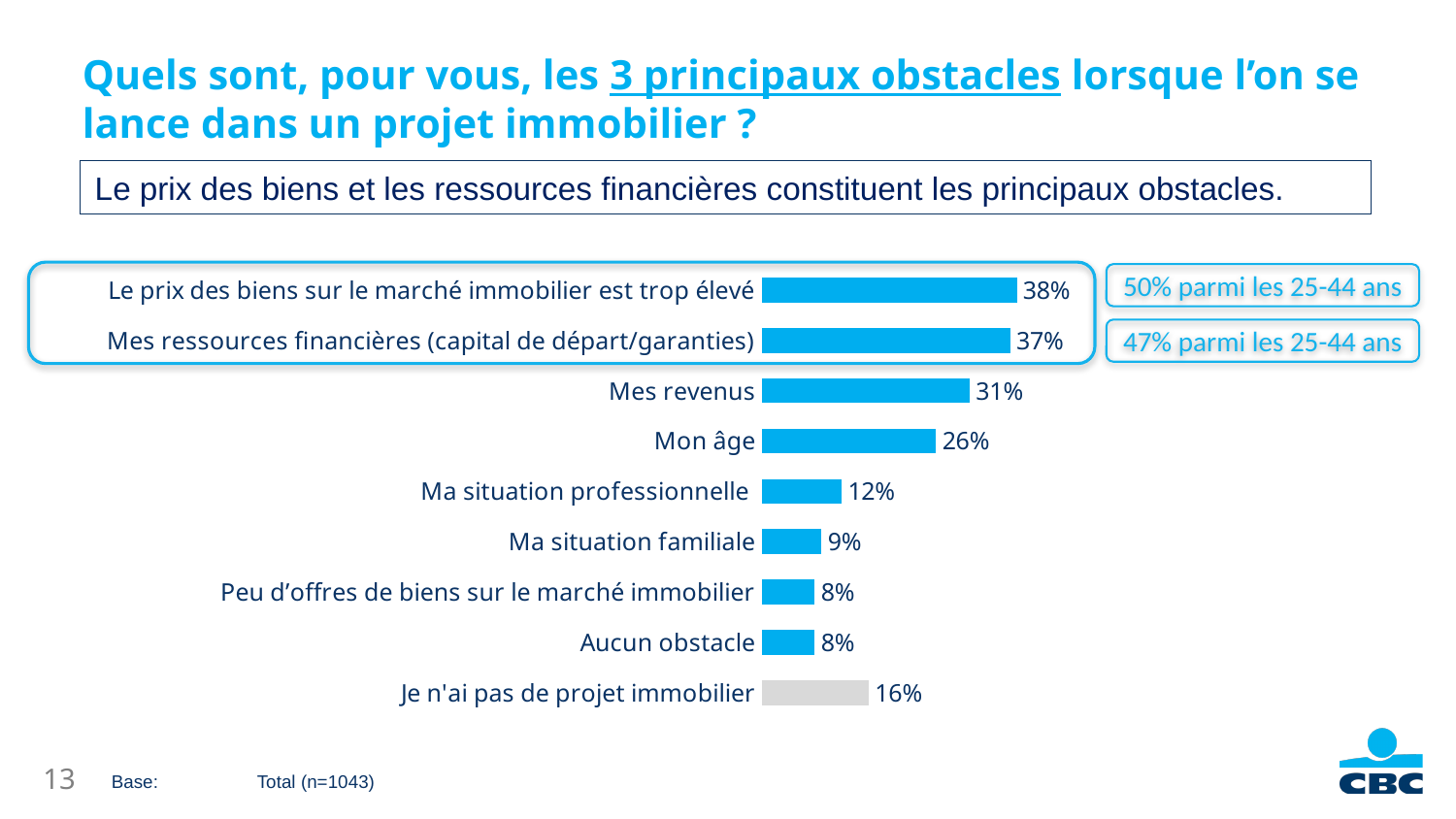
What is the value for "Ma situation professionnelle"? 12% What is the value for "Mes revenus"? 31% What is the difference between "Mes revenus" and "Mon âge"? 5% Which bar is shown in a different colour (grey) from the others? Je n'ai pas de projet immobilier What is the value for "Je n'ai pas de projet immobilier"? 16% What is the value for "Ma situation familiale"? 9% What is the value for "Mon âge"? 26% How many categories are shown in the chart? 9 What kind of chart is shown on the slide? Bar chart Which is larger, "Ma situation professionnelle" or "Ma situation familiale"? Ma situation professionnelle What is the difference between "Le prix des biens sur le marché immobilier est trop élevé" and "Mes ressources financières (capital de départ/garanties)"? 1% Which category has the highest value? Le prix des biens sur le marché immobilier est trop élevé